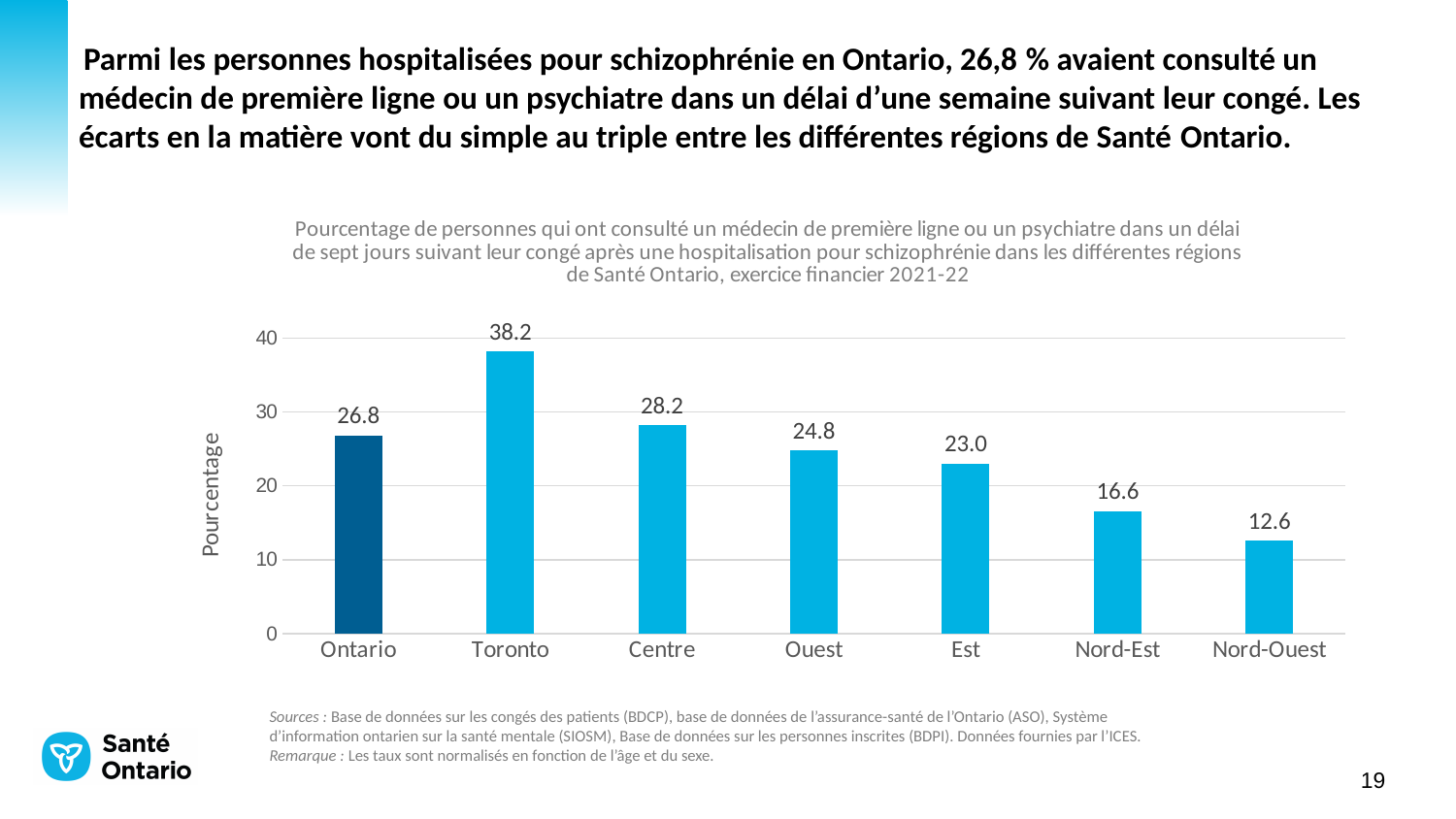
Which region has the lowest value? Nord-Ouest Which region has the highest value? Toronto Which is larger, the value for Est or the value for Nord-Est? Est What is the value for Nord-Est? 16.6 What is the difference between the values for Centre and Ouest? 3.4 What kind of chart is shown? Bar chart What is the difference between the values for Toronto and Nord-Ouest? 25.6 What is the value for Ontario? 26.8 How many categories are shown on the x axis? 7 What is the label of the y axis? Pourcentage Is the value for Ouest greater or less than 20? greater What is the value for Toronto? 38.2